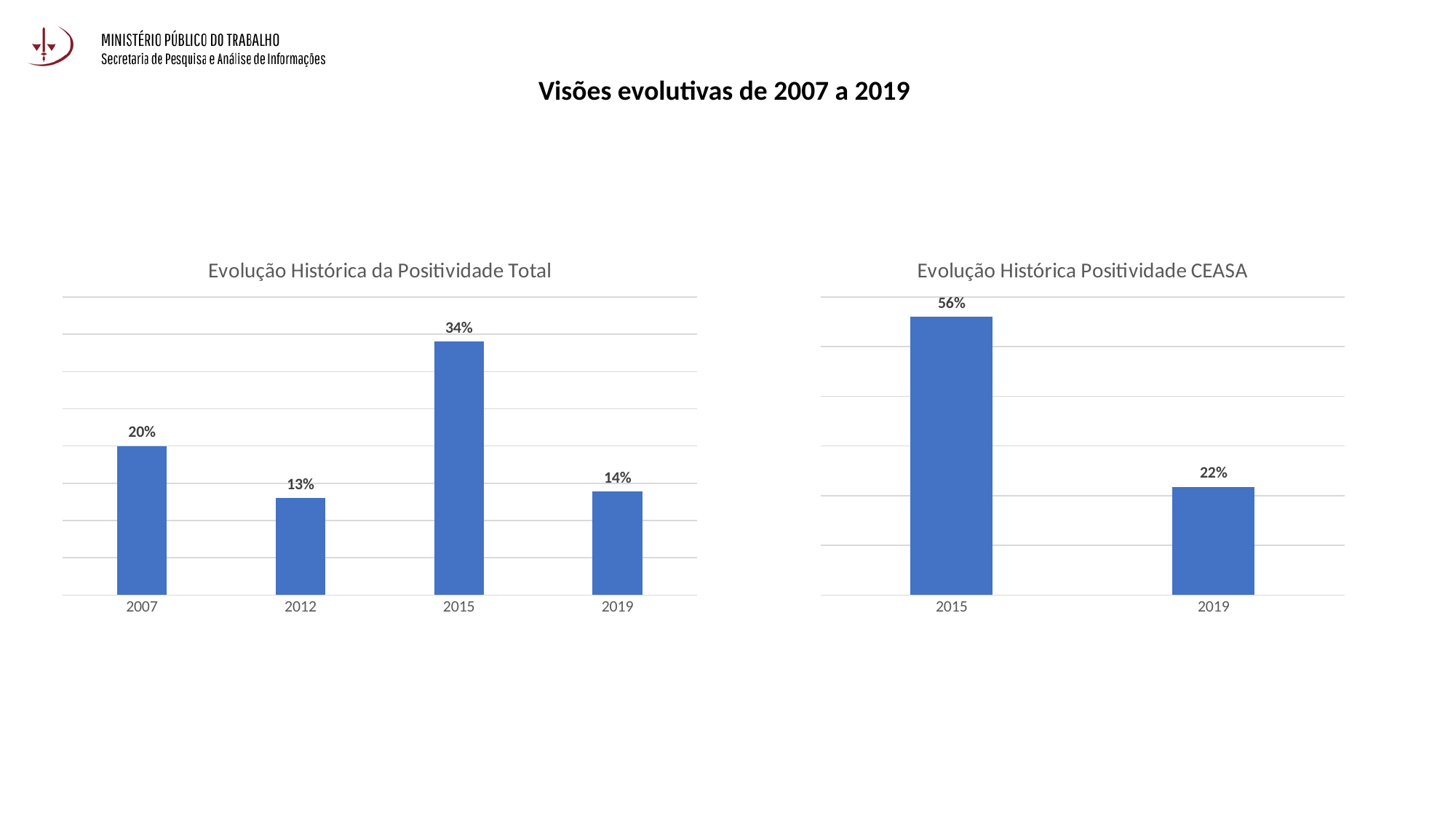
In the chart 'Evolução Histórica da Positividade Total', is the value for 2007 larger or smaller than the value for 2019? larger In the chart 'Evolução Histórica da Positividade Total', which year has the lowest value? 2012 What kind of chart is 'Evolução Histórica Positividade CEASA'? bar chart In the chart 'Evolução Histórica da Positividade Total', what is the difference between the values for 2015 and 2019? 20% In the chart 'Evolução Histórica da Positividade Total', what is the value for 2012? 13% In the chart 'Evolução Histórica Positividade CEASA', what is the value for 2019? 22% In the chart 'Evolução Histórica Positividade CEASA', do the values rise or fall from 2015 to 2019? fall In the chart 'Evolução Histórica da Positividade Total', how many years are shown on the x axis? 4 In the chart 'Evolução Histórica da Positividade Total', what is the value for 2007? 20% In the chart 'Evolução Histórica Positividade CEASA', what is the value for 2015? 56% In the chart 'Evolução Histórica Positividade CEASA', what is the difference between the values for 2015 and 2019? 34% In the chart 'Evolução Histórica da Positividade Total', which year has the highest value? 2015